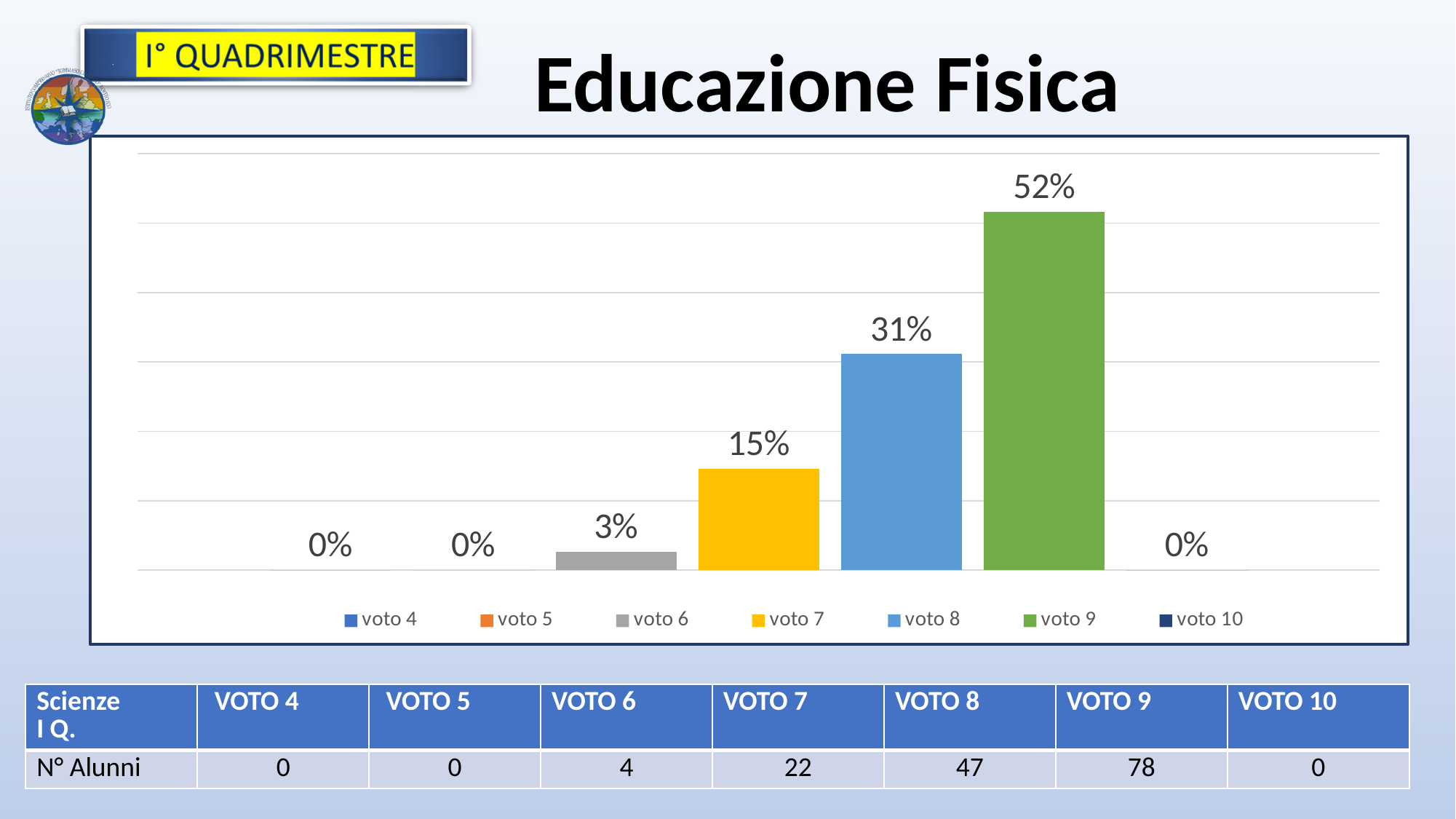
Which is larger, the value for voto 7 or the value for voto 6? voto 7 What percentage is shown for voto 6? 3% What percentage is shown for voto 8? 31% What percentage is shown for voto 9? 52% What percentage is shown for voto 7? 15% Which voto has the highest percentage? voto 9 What is the difference in percentage points between voto 8 and voto 7? 16% What colour is the bar for voto 9? green What kind of chart is shown on the slide? bar chart What is the difference in percentage points between voto 9 and voto 8? 21% How many voto categories show a value of 0%? 3 How many series does the legend list? 7